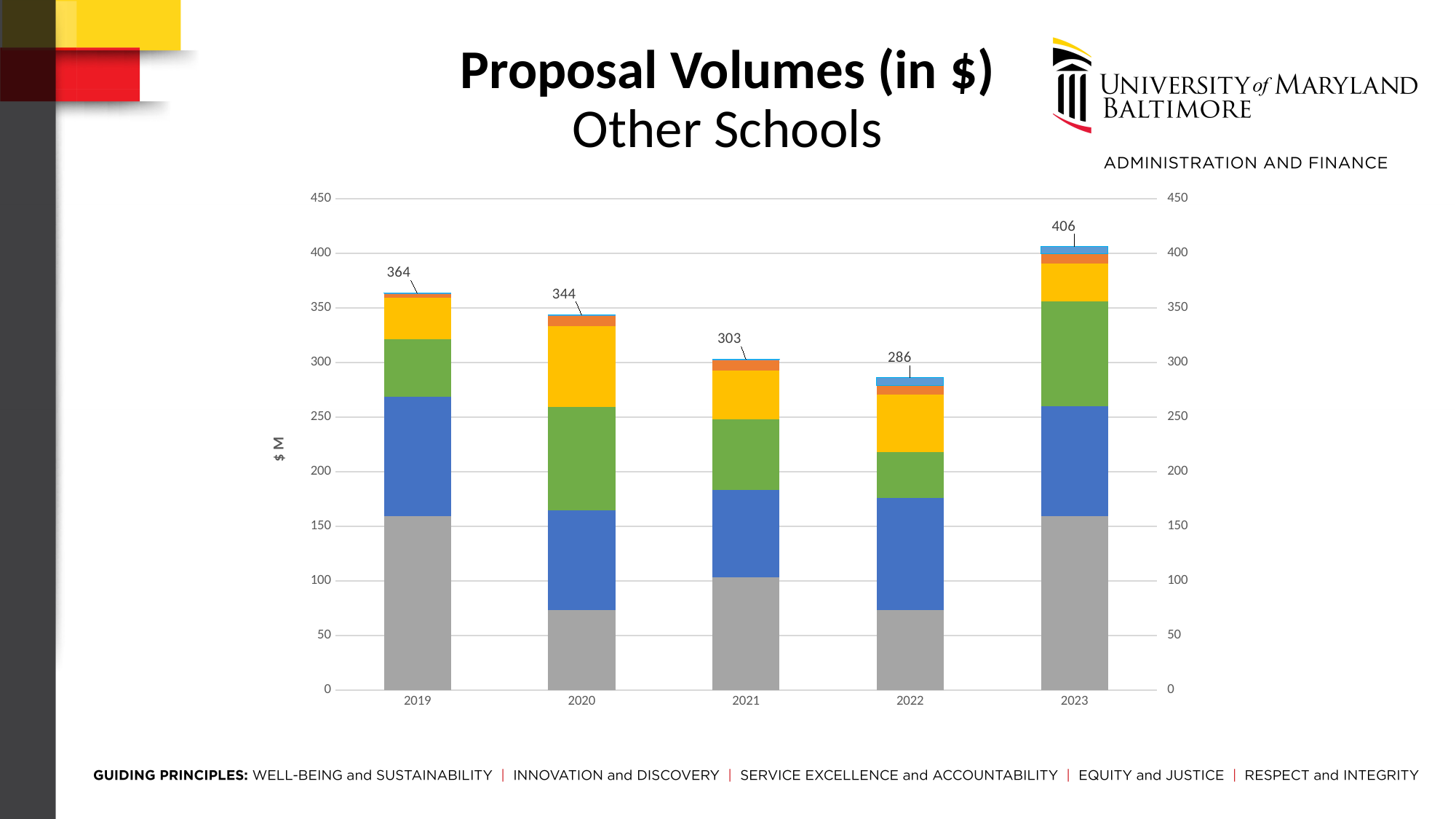
What is the difference between the total for 2023 and the total for 2022? 120 What kind of chart is shown on the slide? stacked bar chart What is the total proposal volume shown for 2021? 303 Is the value of the gray (bottom) segment for 2020 greater or less than 100? less How many years are shown on the x axis? 5 What is the total proposal volume shown for 2023? 406 Do the total proposal volumes rise or fall from 2019 to 2022? fall Which year has the lowest total proposal volume? 2022 What is the difference between the total for 2019 and the total for 2020? 20 Which year has a larger total, 2020 or 2021? 2020 Which year has the highest total proposal volume? 2023 What is the total proposal volume shown for 2019? 364